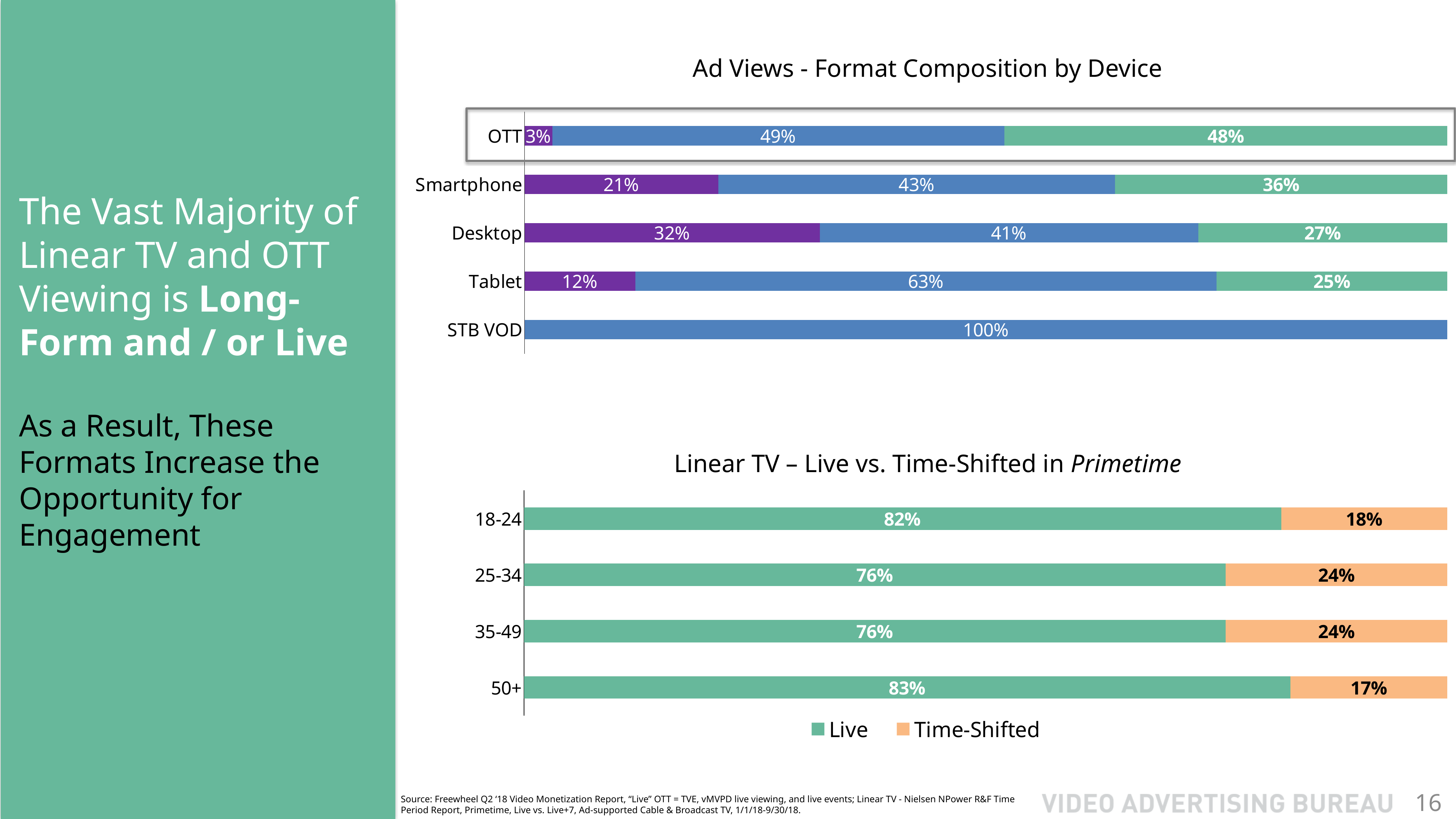
In the 'Linear TV – Live vs. Time-Shifted in Primetime' chart, what is the Live value for 18-24? 82% What kind of chart is 'Linear TV – Live vs. Time-Shifted in Primetime'? Stacked bar chart In the 'Ad Views - Format Composition by Device' chart, what is the value of the green segment for OTT? 48% In the 'Linear TV – Live vs. Time-Shifted in Primetime' chart, how many series does the legend list? 2 In the 'Ad Views - Format Composition by Device' chart, what is the difference between the blue segment for Tablet and the blue segment for Desktop? 22% In the 'Ad Views - Format Composition by Device' chart, what value is shown for STB VOD? 100% In the 'Linear TV – Live vs. Time-Shifted in Primetime' chart, which age group has the lowest Time-Shifted share? 50+ In the 'Ad Views - Format Composition by Device' chart, how many device categories are shown? 5 In the 'Linear TV – Live vs. Time-Shifted in Primetime' chart, which age group has the highest Live share? 50+ In the 'Ad Views - Format Composition by Device' chart, what is the value of the purple segment for Desktop? 32% In the 'Ad Views - Format Composition by Device' chart, which device has the largest purple segment? Desktop In the 'Ad Views - Format Composition by Device' chart, what is the value of the blue segment for Tablet? 63%